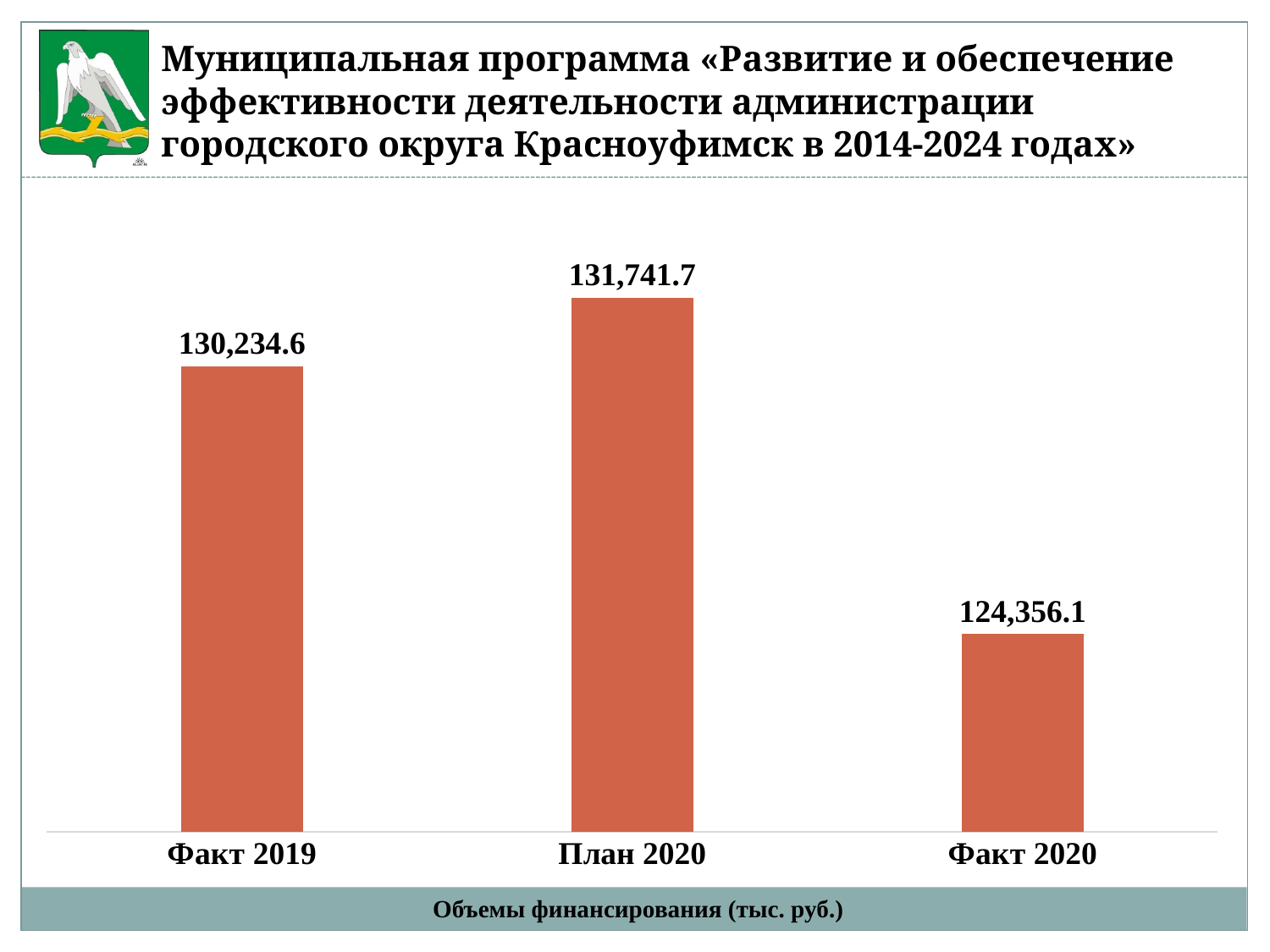
What is the value for План 2020? 131,741.7 In what units are the financing volumes given, according to the caption below the chart? тыс. руб. Which category has the highest value? План 2020 What is the value for Факт 2020? 124,356.1 How many categories are shown in the chart? 3 What is the value for Факт 2019? 130,234.6 What is the difference between План 2020 and Факт 2020? 7,385.6 What kind of chart is shown on the slide? Bar chart Which is larger, Факт 2019 or Факт 2020? Факт 2019 Which category has the lowest value? Факт 2020 What is the difference between План 2020 and Факт 2019? 1,507.1 What is the difference between Факт 2019 and Факт 2020? 5,878.5